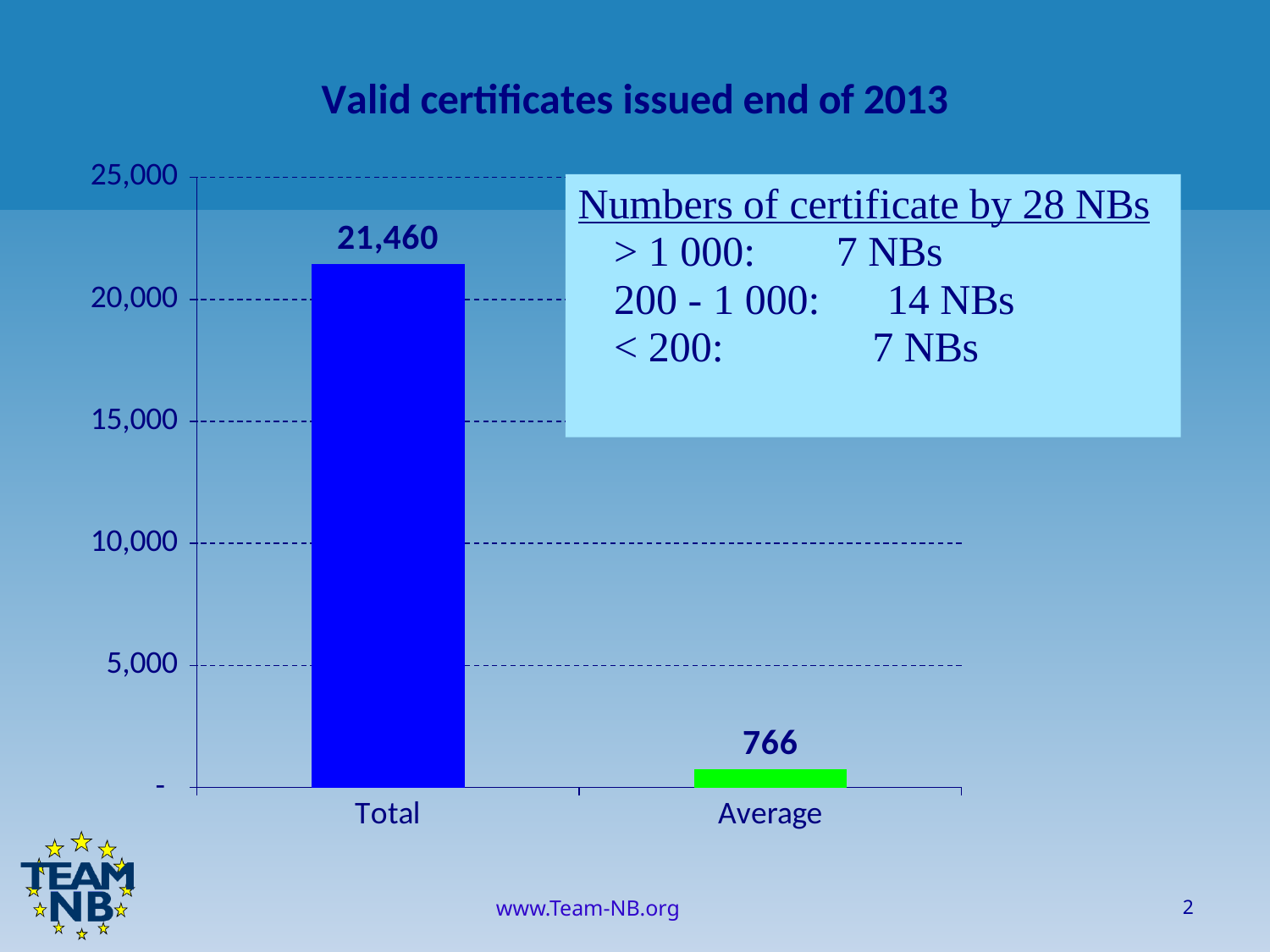
Which category has the highest value? Total What is the title of the chart? Valid certificates issued end of 2013 What colour is the Average bar? green What is the difference between the Total and Average values? 20,694 Which is larger, the Total bar or the Average bar? Total How many categories are shown on the x axis? 2 What is the value of the Average bar? 766 Is the value for Average greater or less than 5,000? less Is the value for Total greater or less than 20,000? greater What is the value of the Total bar? 21,460 Which category has the lowest value? Average What kind of chart is shown on the slide? bar chart